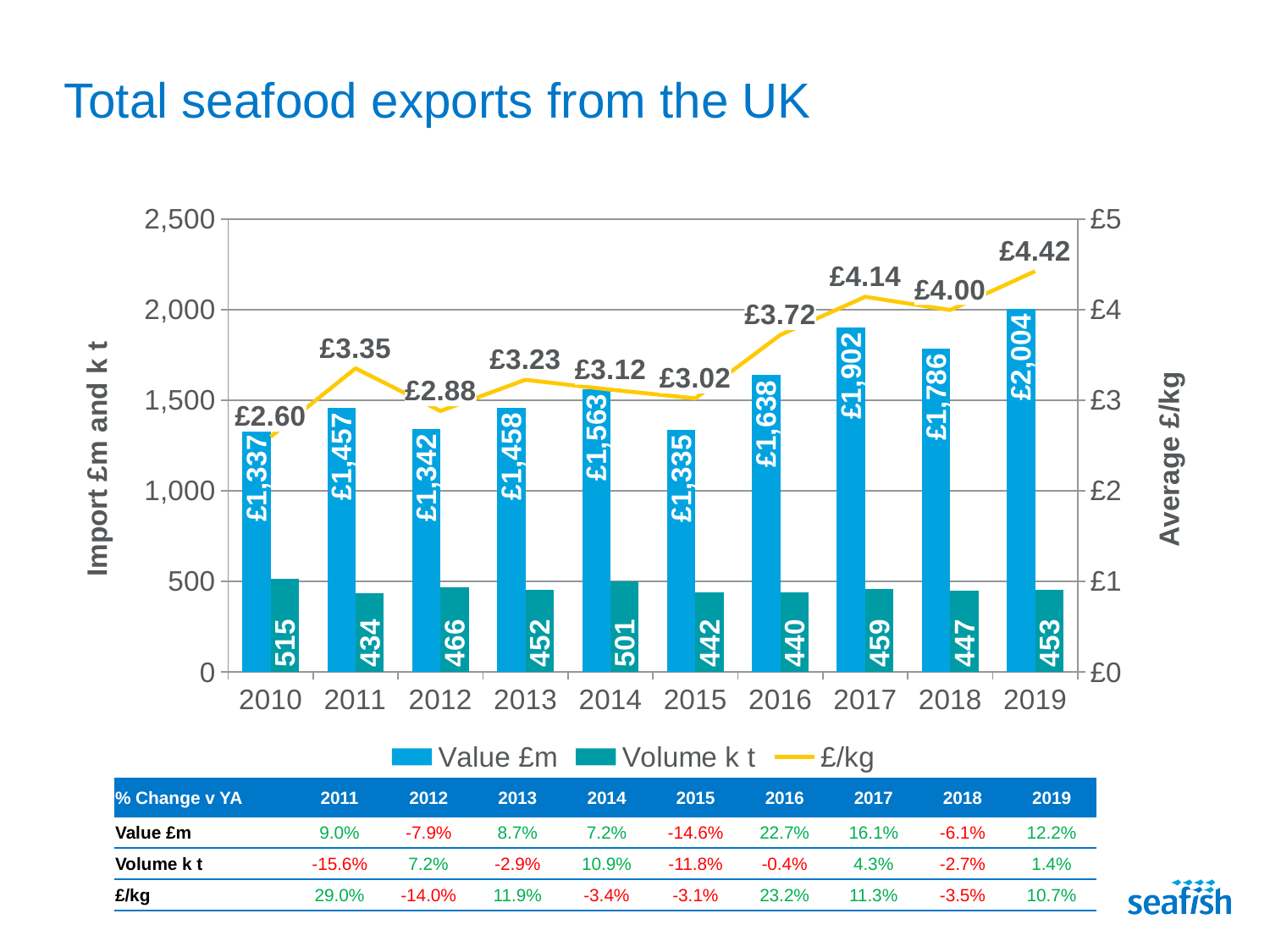
Which year has the highest Value £m? 2019 What kind of chart is this? Combined bar and line chart What is the £/kg value for 2016? £3.72 What is the difference in Value £m between 2017 and 2018? £116 What is the Value £m for 2019? £2,004 Which year has the lowest £/kg? 2010 How many years are shown on the x axis? 10 What is the title of the slide? Total seafood exports from the UK What is the Volume k t for 2014? 501 How many series does the legend list? 3 Which is larger, the Volume k t for 2010 or for 2011? 2010 Which year has the lowest Volume k t? 2016